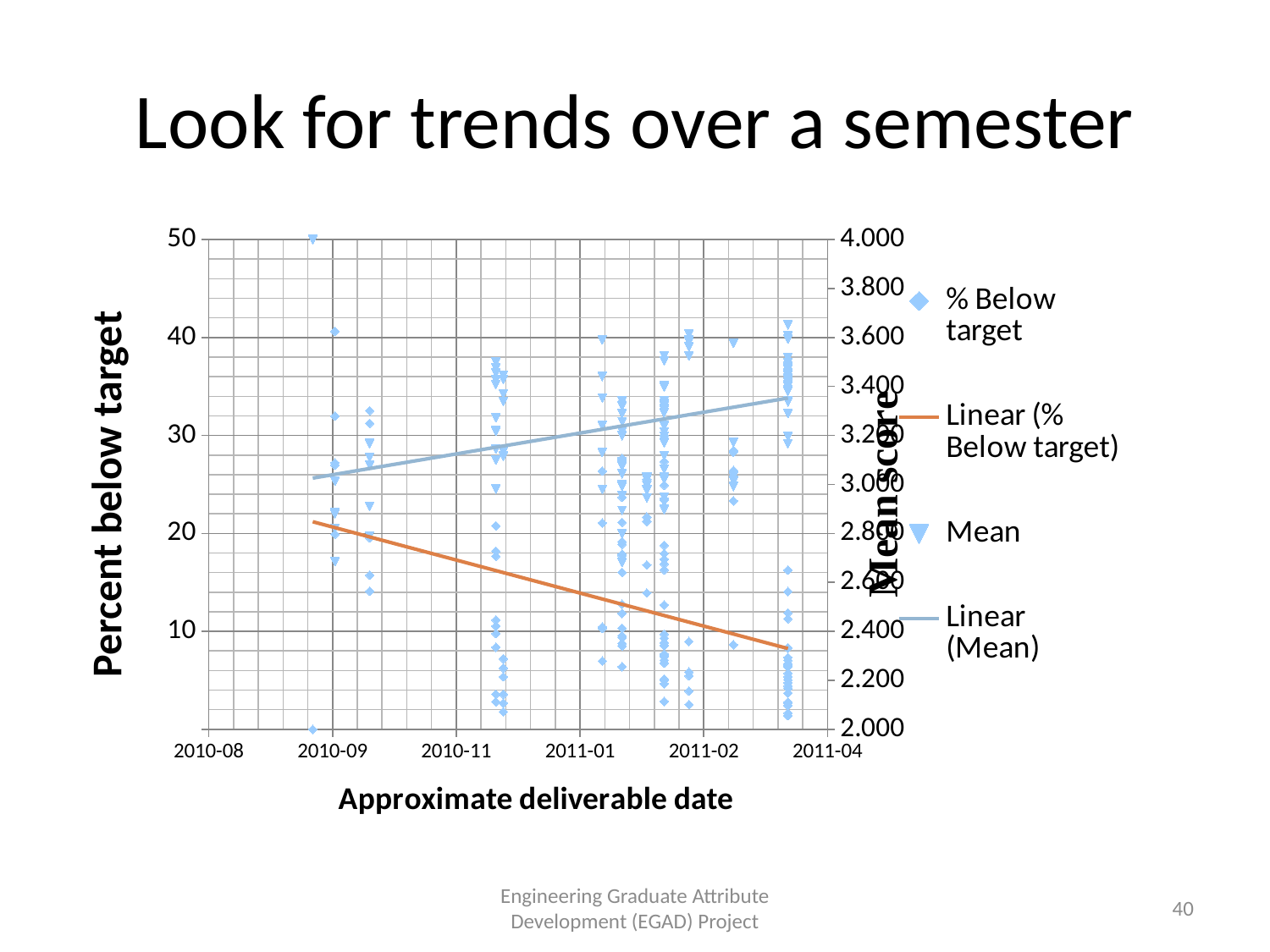
How many entries does the chart's legend list? 4 What is the highest tick value shown on the left vertical axis (Percent below target)? 50 What is the title of the left vertical axis of the chart? Percent below target What is the title of the chart's x axis? Approximate deliverable date How many date tick labels are shown along the x axis? 6 Does the Linear (Mean) trend line rise or fall from left to right along the x axis? Rise What is the lowest value shown on the right vertical axis (Mean score)? 2.000 What kind of chart is shown on the slide? Scatter chart What is the highest value shown on the right vertical axis (Mean score)? 4.000 Which legend entry is plotted with a downward-pointing triangle marker? Mean Does the Linear (% Below target) trend line rise or fall from left to right along the x axis? Fall